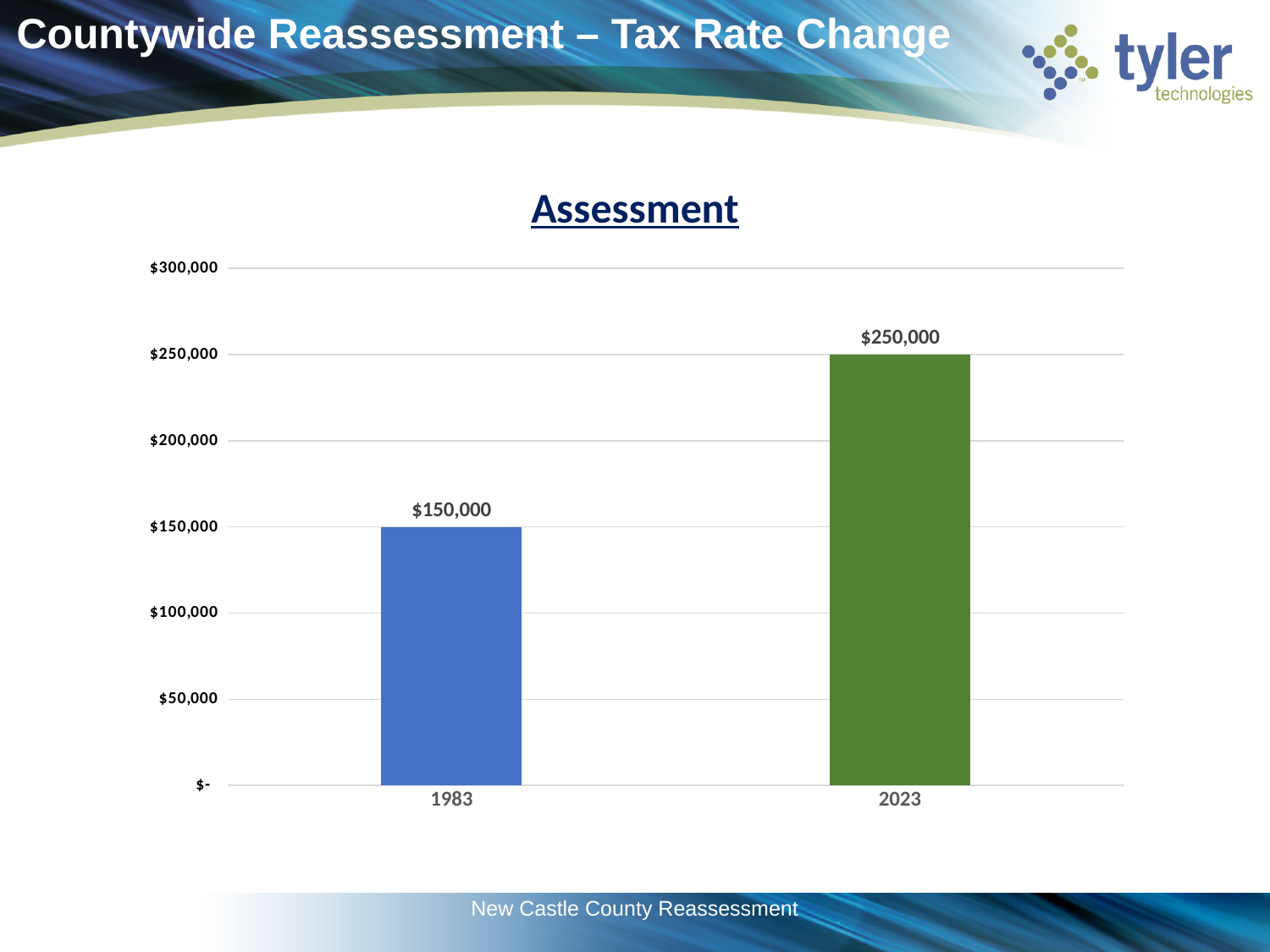
What is the title of the chart? Assessment Is the assessment value for 2023 larger than the value for 1983? Yes How many years are shown on the chart? 2 Is the assessment value for 2023 greater or less than $200,000? greater Is the assessment value for 1983 greater or less than $200,000? less What kind of chart is shown on the slide? Bar chart What is the assessment value for 1983? $150,000 What is the assessment value for 2023? $250,000 Which year has the higher assessment value? 2023 Does the assessment value rise or fall from 1983 to 2023? Rise What is the difference between the 2023 and 1983 assessment values? $100,000 Which year has the lower assessment value? 1983